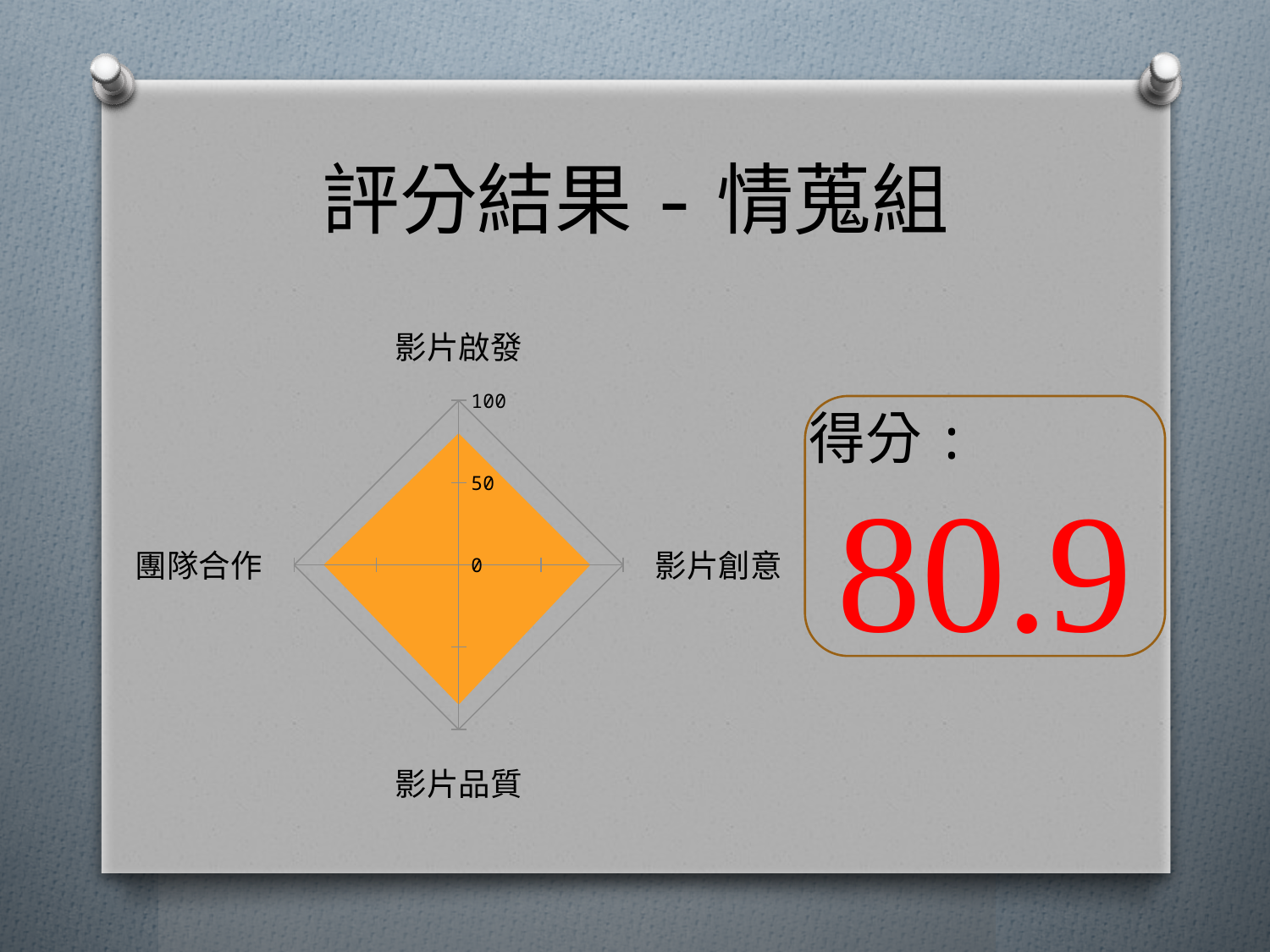
What colour is the filled area of the radar chart? orange How many categories (axes) does the radar chart have? 4 Is the value for 影片啟發 greater or less than 50? greater Is the value for 團隊合作 greater or less than 100? less What is the maximum value shown on the radar chart's axis scale? 100 Which category label appears at the top of the radar chart? 影片啟發 Is the value for 影片創意 greater or less than 50? greater What kind of chart is shown on the slide? radar chart